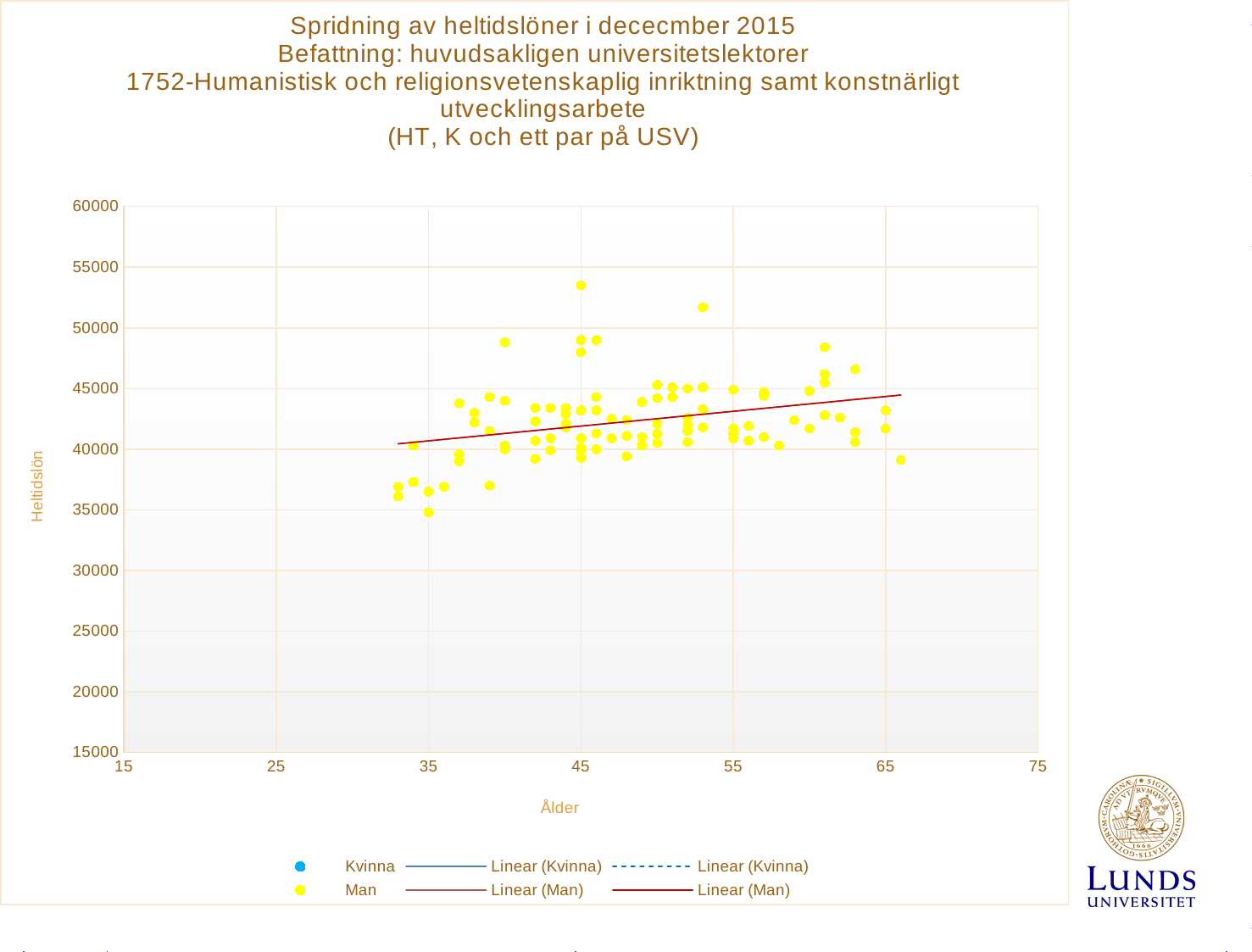
Is the value of the red trend line at age 33 greater or less than 45000? less Is the lowest plotted salary value greater or less than 40000? less What is the title of the x axis? Ålder Is the highest plotted salary value greater or less than 55000? less What is the maximum value shown on the y axis? 60000 What kind of chart is shown on the slide? scatter chart What is the title of the y axis? Heltidslön How many entries does the legend list? 6 Does the red linear trend line for Man rise or fall as age increases? rise